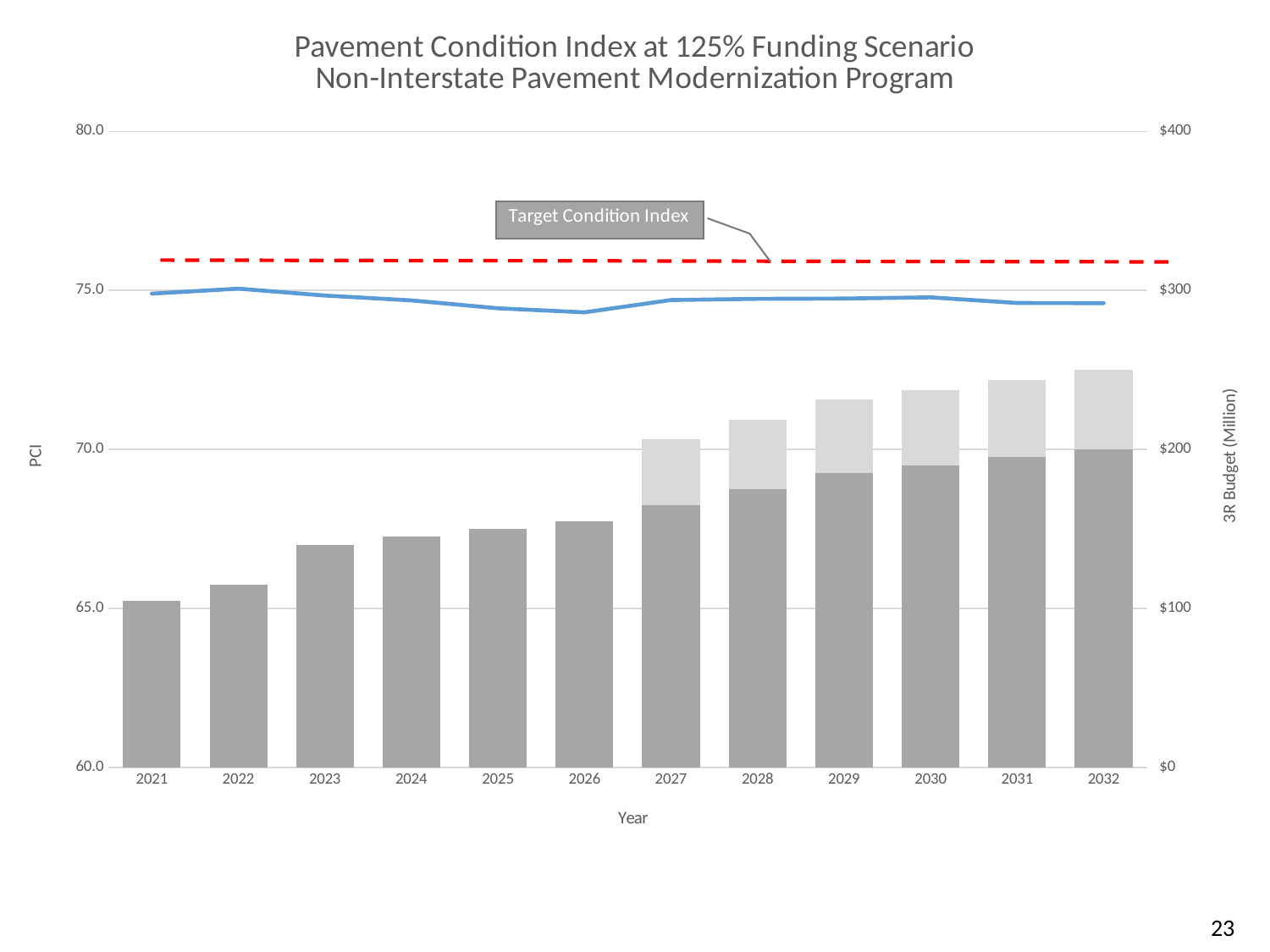
Is the total bar for 2032 greater or less than $200 on the right axis? greater Is the bar for 2026 greater or less than $200 on the right axis? less What is the title of the chart? Pavement Condition Index at 125% Funding Scenario Non-Interstate Pavement Modernization Program What is the label of the right-hand vertical axis? 3R Budget (Million) Do the bar heights rise or fall from 2021 to 2032? Rise Is the bar for 2021 greater or less than $100 on the right axis? greater Which year has the tallest stacked bar? 2032 Which year has the shortest bar? 2021 In which year does the blue PCI line reach its lowest point? 2026 How many years are shown along the x axis? 12 What kind of chart is shown on the slide? A combined bar and line chart